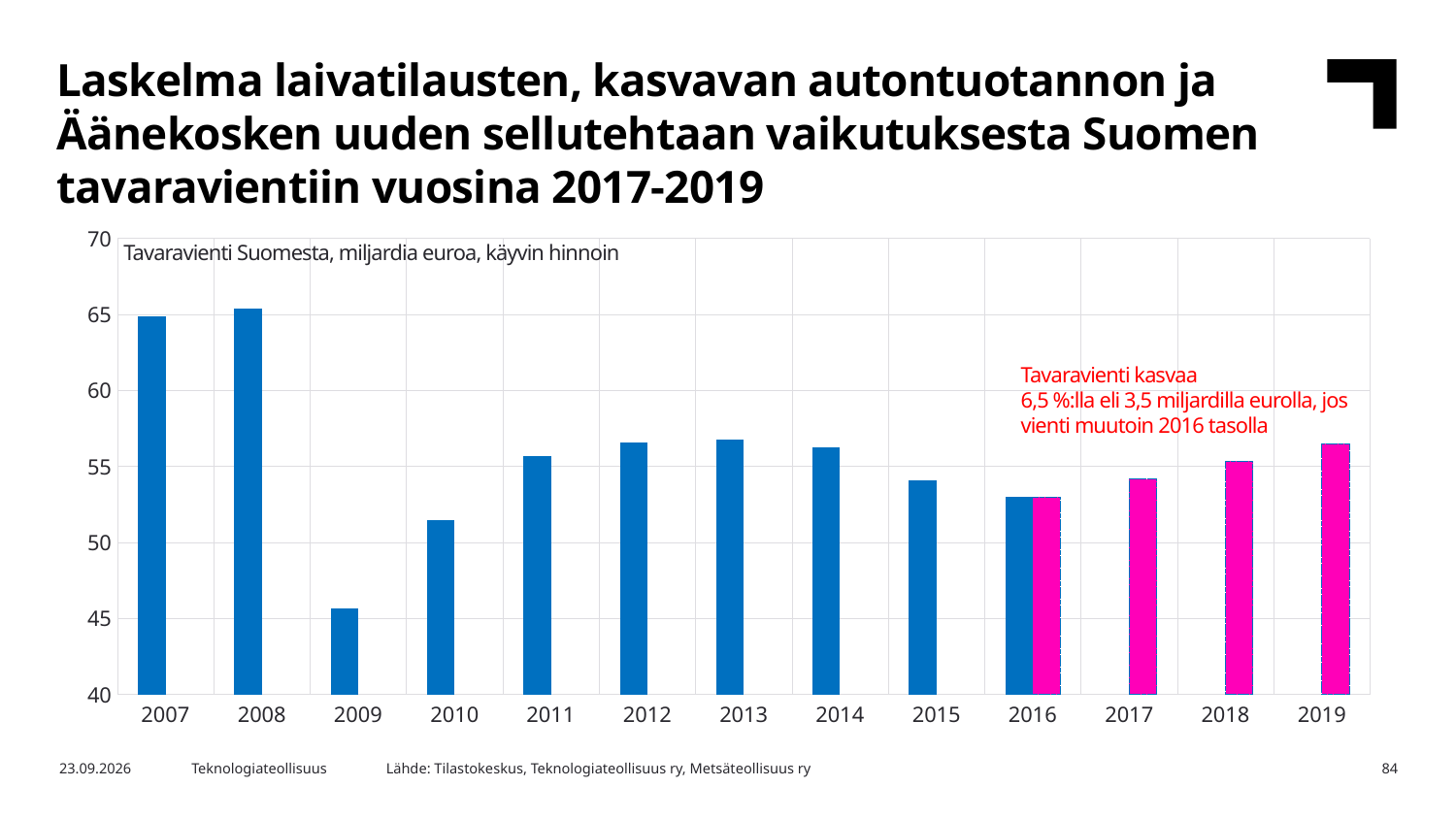
Do the values rise or fall from 2016 to 2019? rise Is the value for 2019 greater or less than 55? greater Which year has the larger value, 2007 or 2016? 2007 What kind of chart is shown on the slide? bar chart Which year has the lowest value in the chart? 2009 What is the text label shown inside the top of the chart area? Tavaravienti Suomesta, miljardia euroa, käyvin hinnoin How many years are shown on the x axis of the chart? 13 What colour are the bars for 2017, 2018 and 2019? magenta Is the value for 2009 greater or less than 50? less Which year has the larger value, 2009 or 2010? 2010 Is the value for 2010 greater or less than 50? greater